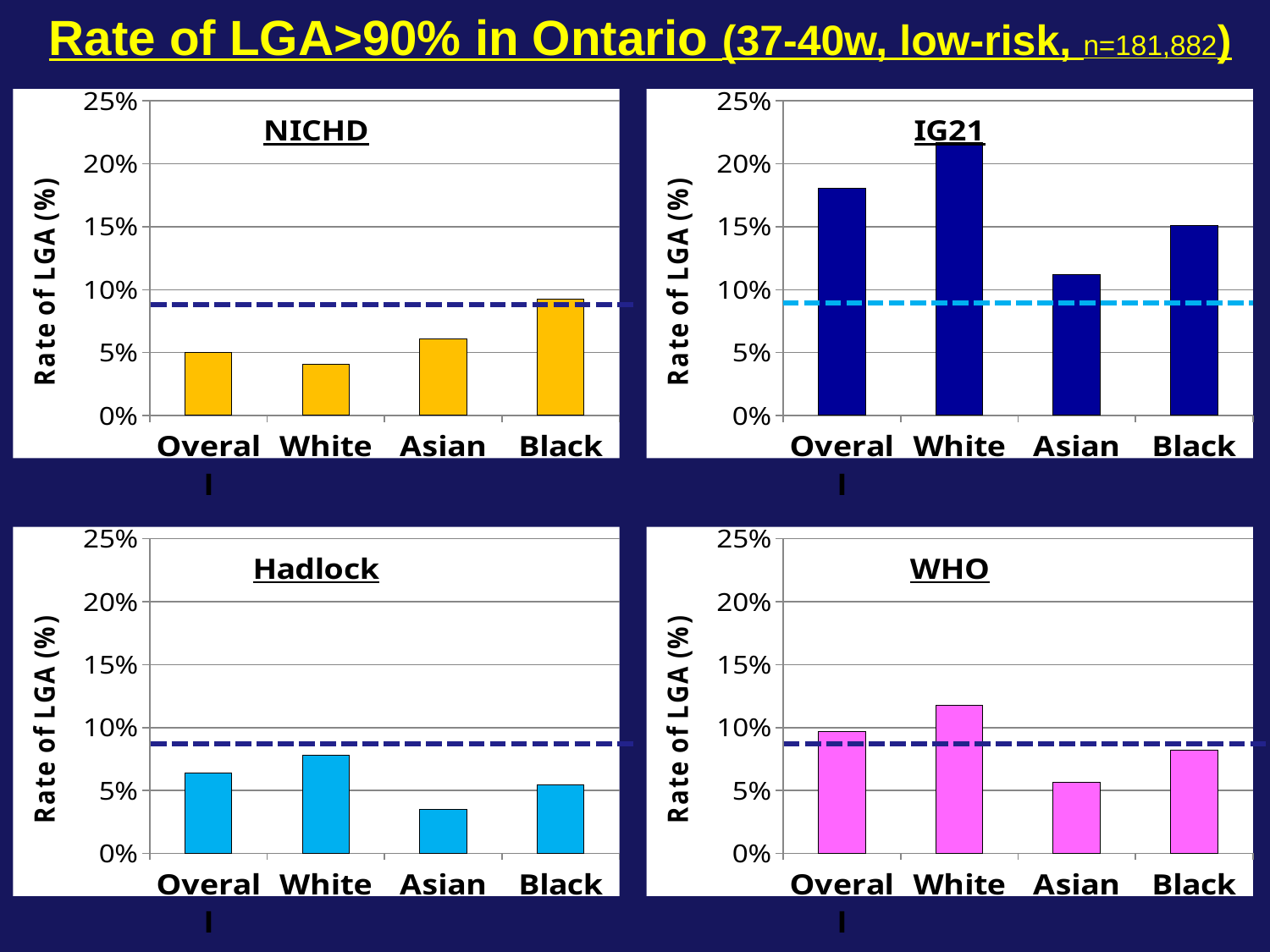
What is the title of the chart in the bottom-right position of the slide? WHO In the Hadlock chart, is the value for Asian greater or less than 5%? less In the Hadlock chart, which category has the lowest rate of LGA? Asian How many categories are shown on the x axis of the IG21 chart? 4 What kind of chart is the NICHD chart? bar chart In the WHO chart, is the value for White greater or less than 10%? greater In the NICHD chart, which category has the highest rate of LGA? Black In the NICHD chart, which is larger, the value for Asian or the value for White? Asian In the IG21 chart, which category has the highest rate of LGA? White In the IG21 chart, is the value for White greater or less than 20%? greater In the WHO chart, which category has the highest rate of LGA? White In the IG21 chart, which category has the lowest rate of LGA? Asian